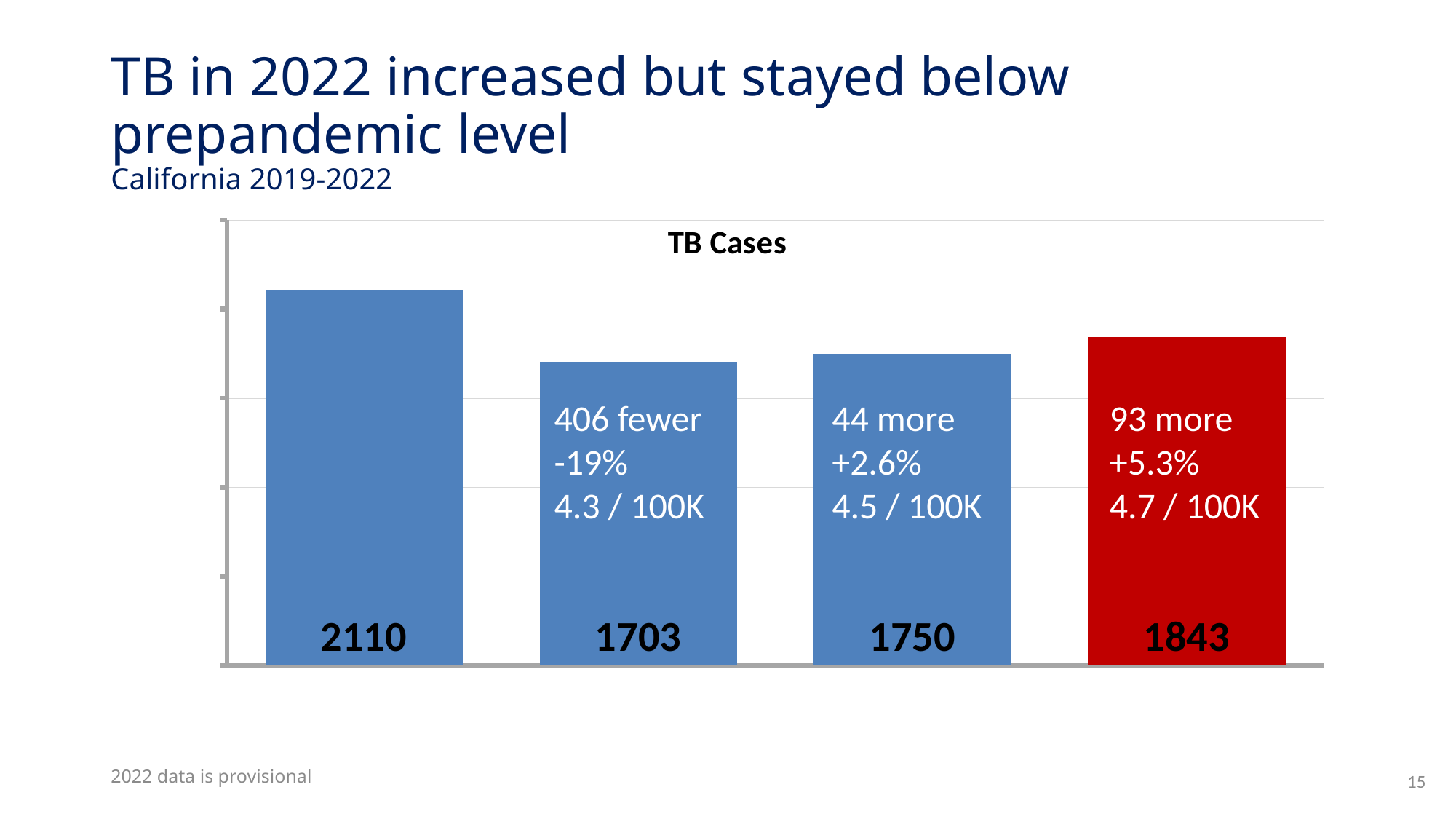
What is the difference between the rightmost bar and the third bar in the TB Cases chart? 93 What type of chart is shown on the slide? bar chart What is the difference between the first bar and the second bar in the TB Cases chart? 407 What rate per 100K is printed on the red bar in the TB Cases chart? 4.7 / 100K What is the value of the red (rightmost) bar in the TB Cases chart? 1843 Which bar in the TB Cases chart has the highest value? The first (leftmost) bar, 2110 Is the value of the rightmost bar larger or smaller than the value of the leftmost bar in the TB Cases chart? smaller What is the value of the second bar in the TB Cases chart? 1703 How many bars are shown in the TB Cases chart? 4 What is the value of the first (leftmost) bar in the TB Cases chart? 2110 Which bar in the TB Cases chart has the lowest value? The second bar, 1703 What is the value of the third bar in the TB Cases chart? 1750